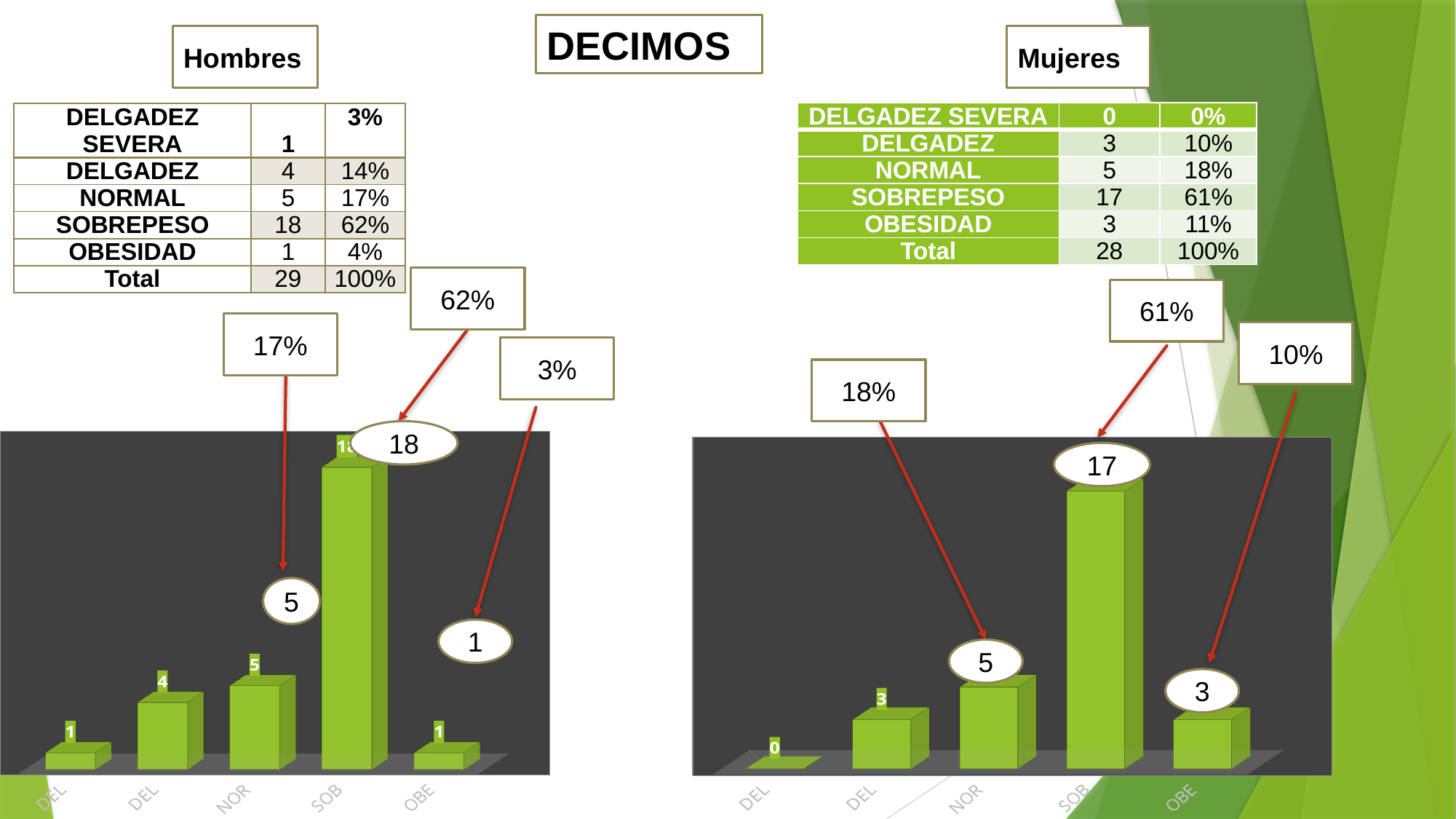
In the Mujeres chart, which category has the lowest bar? DEL (the first bar) In the Mujeres chart, what is the value of the OBE bar? 3 In the Hombres chart, what is the difference between the SOB bar and the NOR bar? 13 In the Mujeres chart, what is the difference between the SOB bar and the OBE bar? 14 In the Mujeres chart, what is the value of the SOB bar? 17 In the Hombres chart, which category has the highest bar? SOB In the Hombres chart, what is the value of the NOR bar? 5 Which is larger: the SOB bar in the Hombres chart or the SOB bar in the Mujeres chart? Hombres How many bars are shown in the Hombres chart? 5 In the Mujeres chart, what is the value of the first bar on the left? 0 In the Hombres chart, what is the value of the SOB bar? 18 What type of chart is the Mujeres chart? Bar chart